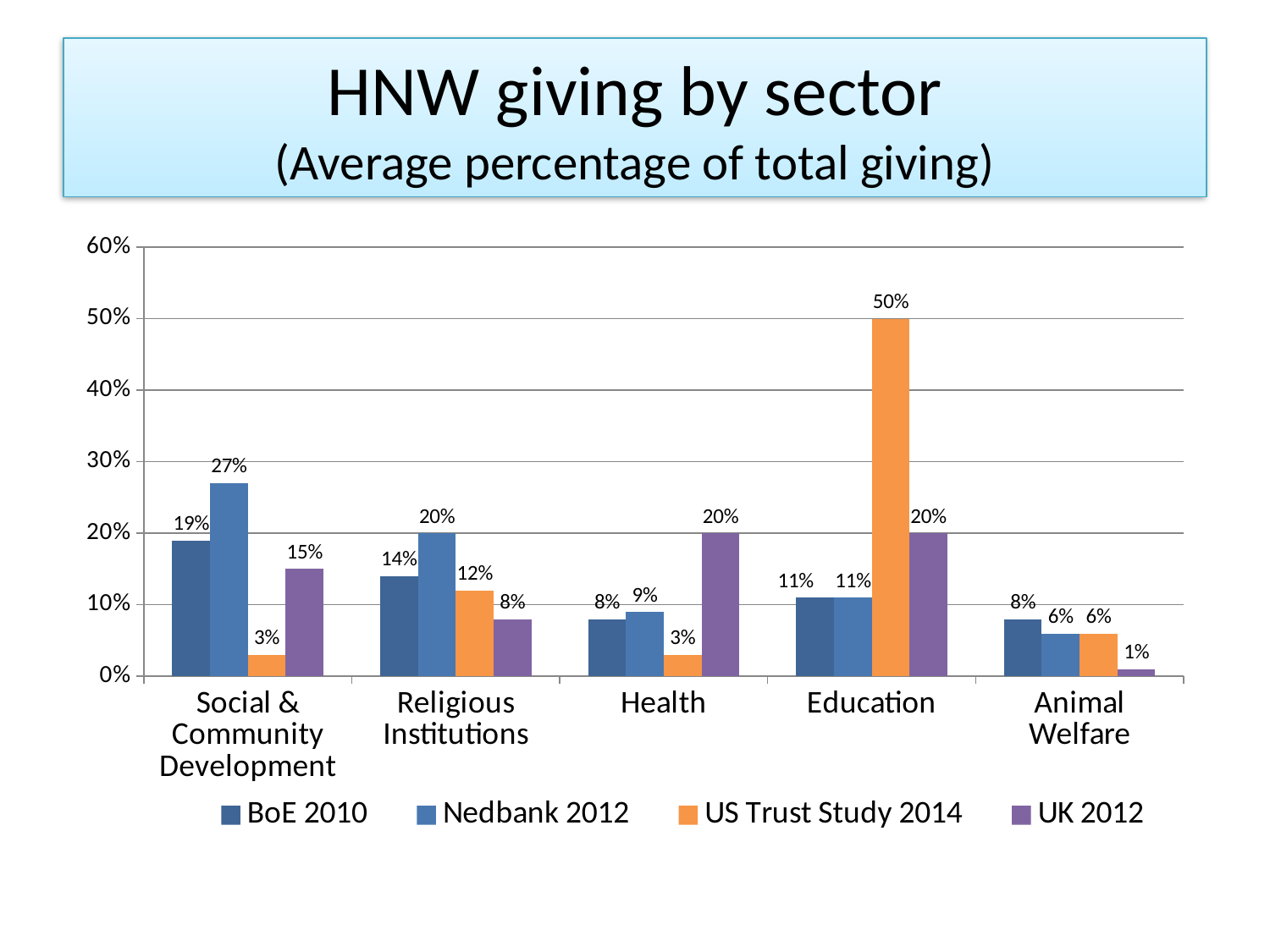
What is the BoE 2010 value for Religious Institutions? 14% What is the UK 2012 value for Health? 20% What is the difference between the Nedbank 2012 and US Trust Study 2014 values for Social & Community Development? 24% For Religious Institutions, which is larger: the Nedbank 2012 value or the UK 2012 value? Nedbank 2012 What is the US Trust Study 2014 value for Education? 50% What kind of chart is shown on the slide? Bar chart How many sectors are shown on the x axis? 5 What is the title of the chart on the slide? HNW giving by sector (Average percentage of total giving) Which sector has the lowest UK 2012 value? Animal Welfare What is the Nedbank 2012 value for Social & Community Development? 27% Which sector has the highest US Trust Study 2014 value? Education How many series does the legend list? 4